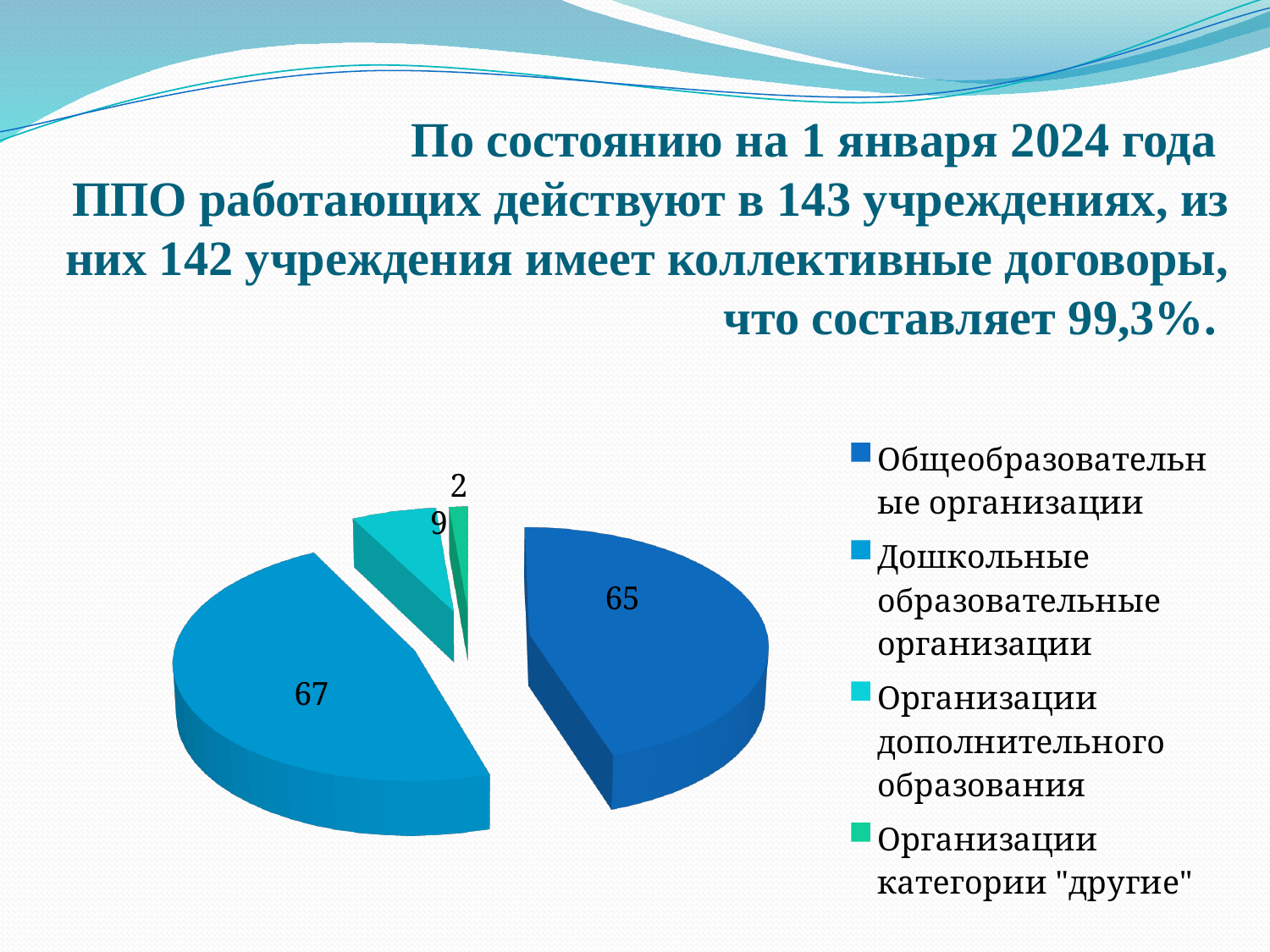
What is the difference between the values for Дошкольные образовательные организации and Общеобразовательные организации? 2 What is the value for Организации категории "другие"? 2 Which category has the largest slice of the pie? Дошкольные образовательные организации What is the value for Организации дополнительного образования? 9 What is the total of all the slices in the pie chart? 143 What is the difference between the values for Организации дополнительного образования and Организации категории "другие"? 7 How many categories does the pie chart have? 4 What is the value for Общеобразовательные организации? 65 What type of chart is shown on the slide? pie chart What is the value for Дошкольные образовательные организации? 67 Which is larger: the value for Общеобразовательные организации or the value for Организации дополнительного образования? Общеобразовательные организации Which category has the smallest slice of the pie? Организации категории "другие"